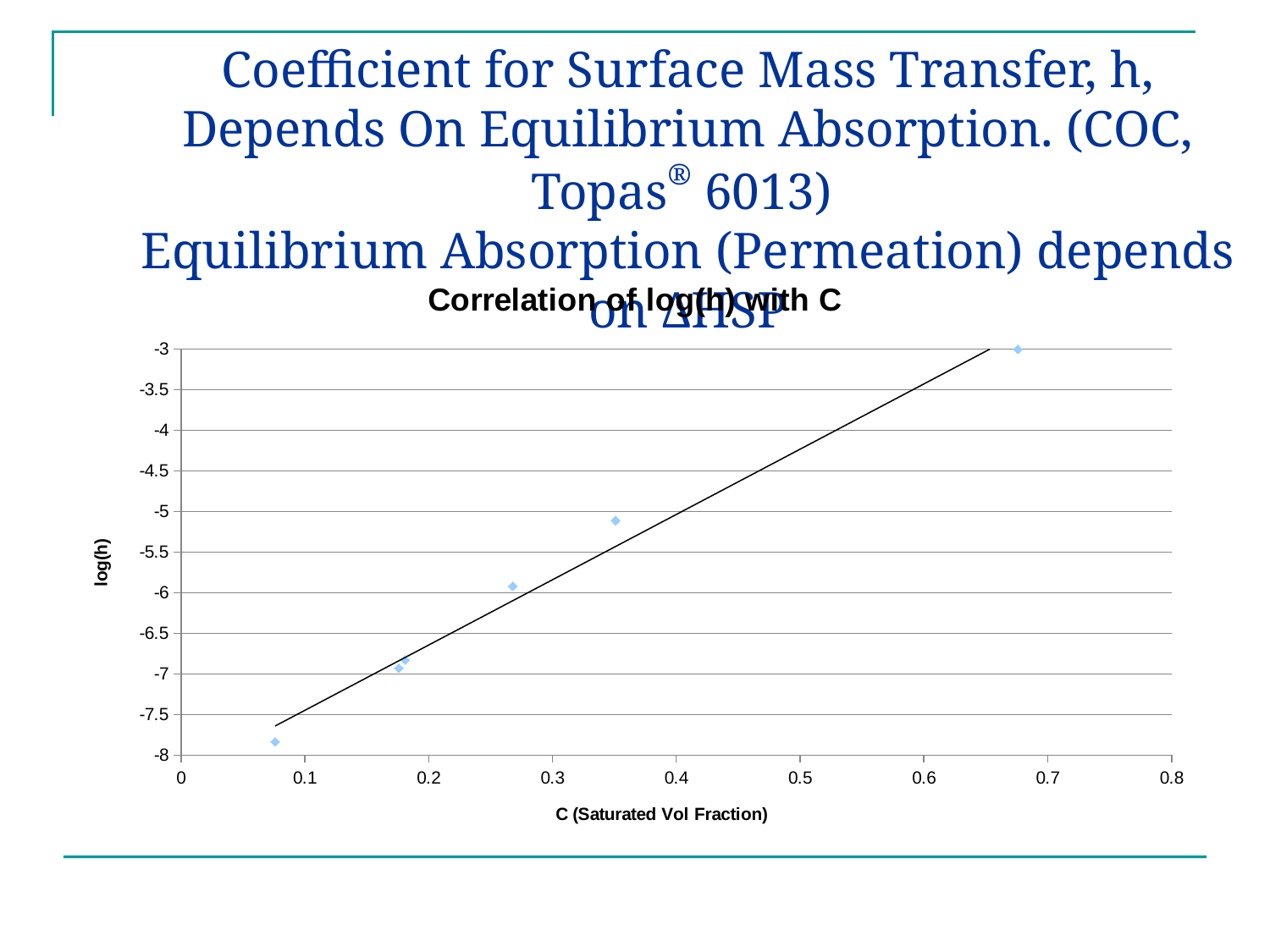
What kind of chart is shown on the slide? scatter chart Is the log(h) value of the data points near C = 0.18 greater or less than -6.5? less Is the log(h) value of the data point near C = 0.27 greater or less than -5.5? less Is the log(h) value of the leftmost data point (near C = 0.1) greater or less than -7.5? less Which has the lower log(h): the data point near C = 0.1 or the data point near C = 0.35? the data point near C = 0.1 What is the label of the x axis of the chart? C (Saturated Vol Fraction) Does the data point with the highest log(h) have the largest or the smallest C value? largest As C increases along the x axis, does log(h) rise or fall? rise What is the title of the chart? Correlation of log(h) with C